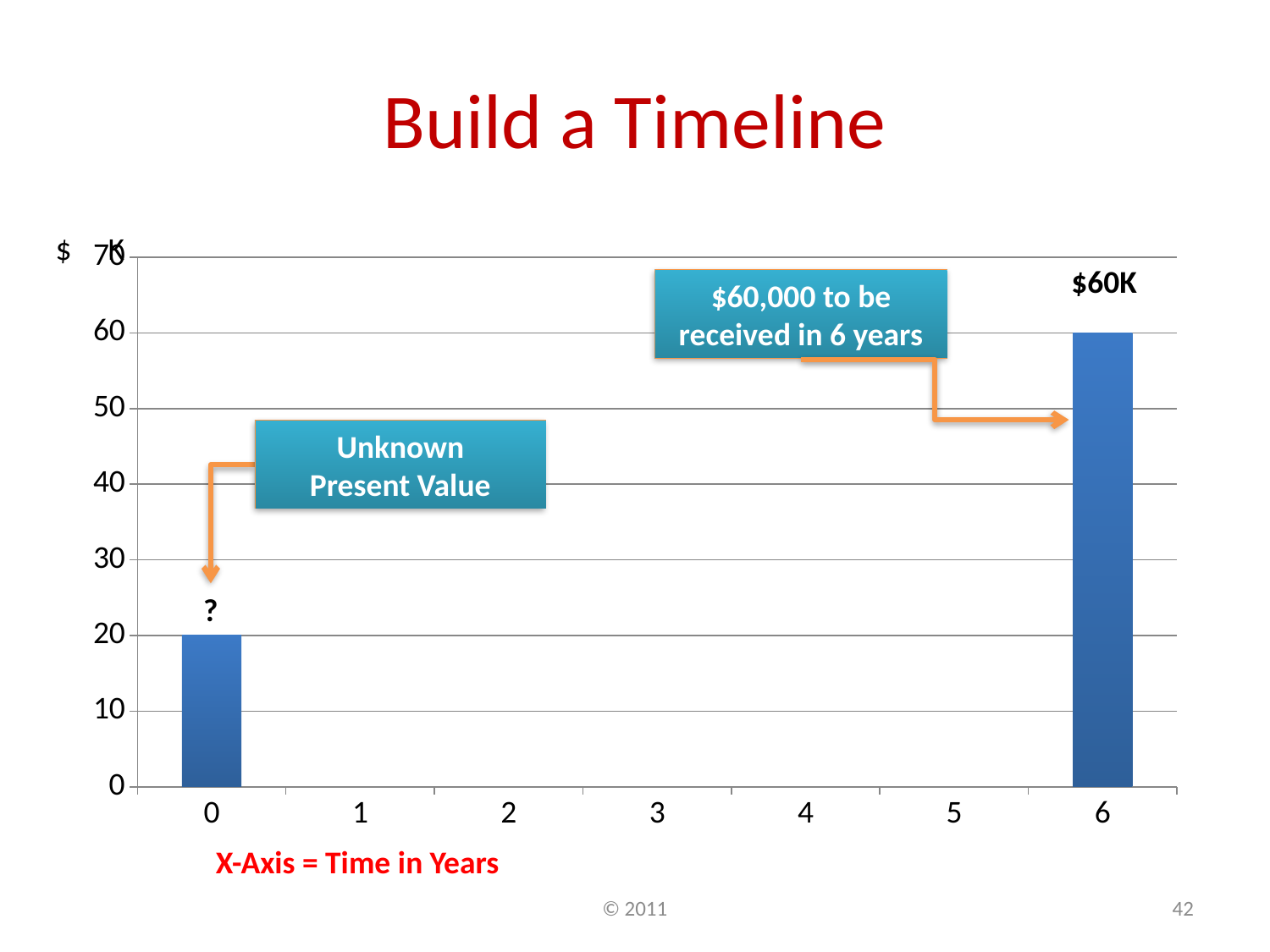
What is the title of the slide containing the chart? Build a Timeline How many year labels are shown on the x axis? 7 Is the value of the bar at year 6 greater or less than 50? greater What is the data label on the bar at year 6? $60K Which year has the shortest bar? 0 Is the value of the bar at year 0 greater or less than 30? less Which year has the tallest bar? 6 What kind of chart is shown on the slide? bar chart What data label appears above the bar at year 0? ? Which bar is taller, the one at year 0 or the one at year 6? year 6 Do the bar values rise or fall from year 0 to year 6? rise How many bars are plotted on the chart? 2